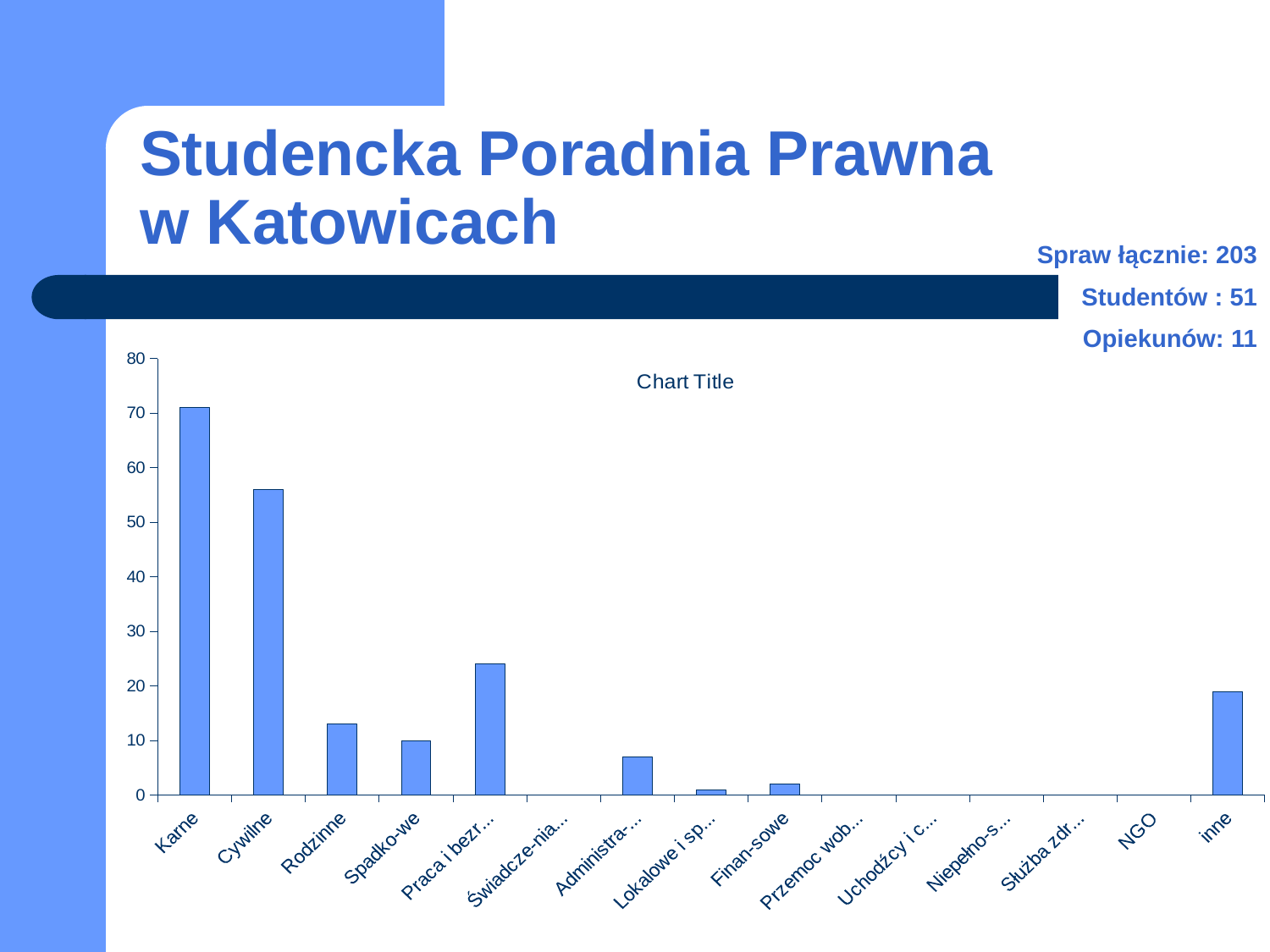
Is the value for Karne greater or less than 60? greater Which is larger, the value for Rodzinne or the value for Lokalowe i sp...? Rodzinne Is the value for Administra-... greater or less than 10? less What is the title shown on the chart? Chart Title What kind of chart is shown on the slide? bar chart Is the value for Praca i bezr... greater or less than 20? greater Which is larger, the value for Praca i bezr... or the value for inne? Praca i bezr... How many categories are shown on the x axis of the chart? 15 Which category has the highest value in the chart? Karne Which is larger, the value for Karne or the value for Cywilne? Karne